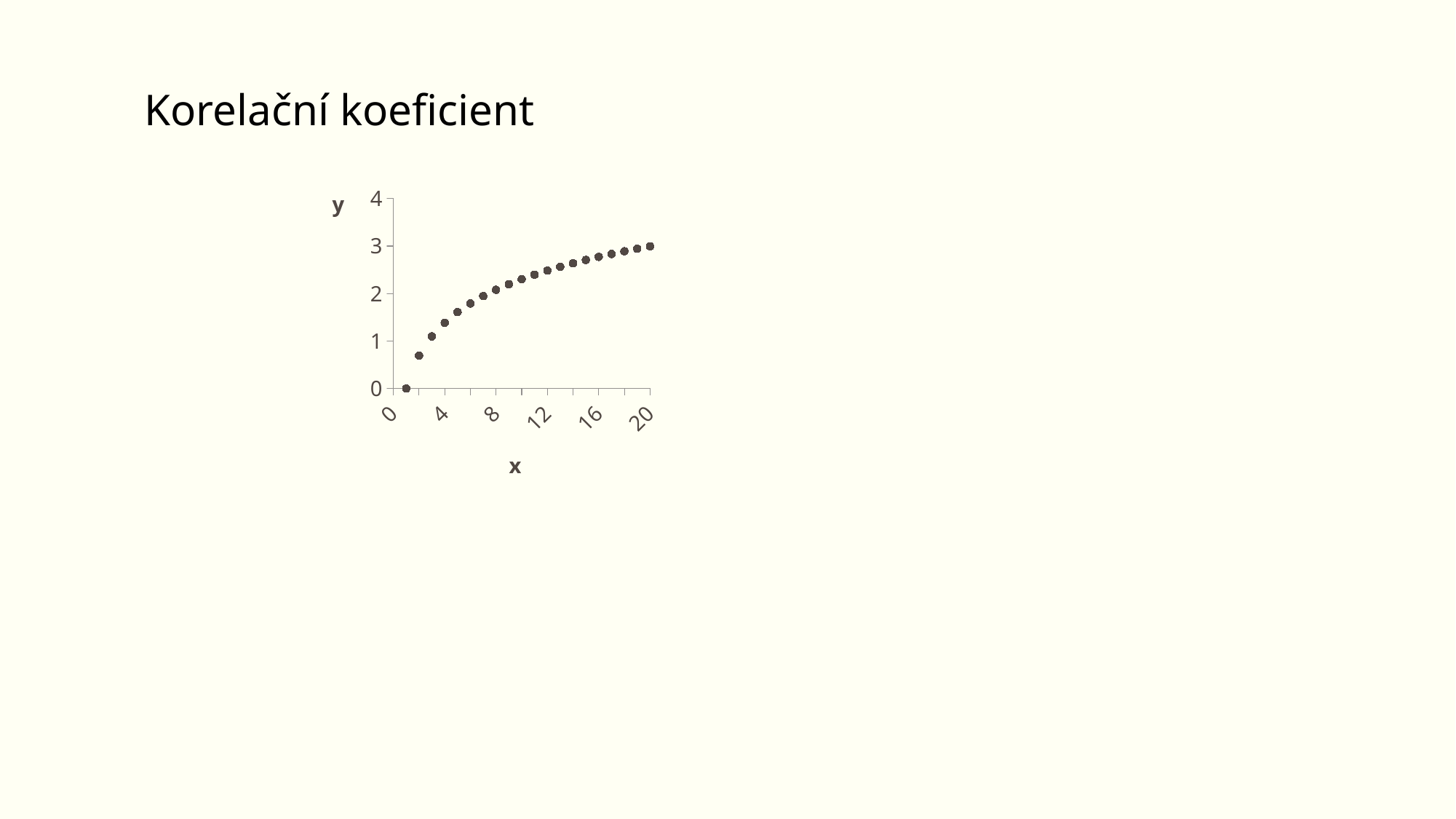
At which x value is the y value highest? 20 Is the y value at x = 4 greater or less than 1? greater Is the y value at x = 12 greater or less than 3? less What is the label of the vertical axis? y Is the y value at x = 2 greater or less than 1? less What is the title of the slide above the chart? Korelační koeficient What kind of chart is shown on the slide? scatter plot Do the y values rise or fall as x increases? rise How many data points are plotted? 20 Which has the larger y value, the point at x = 5 or the point at x = 15? x = 15